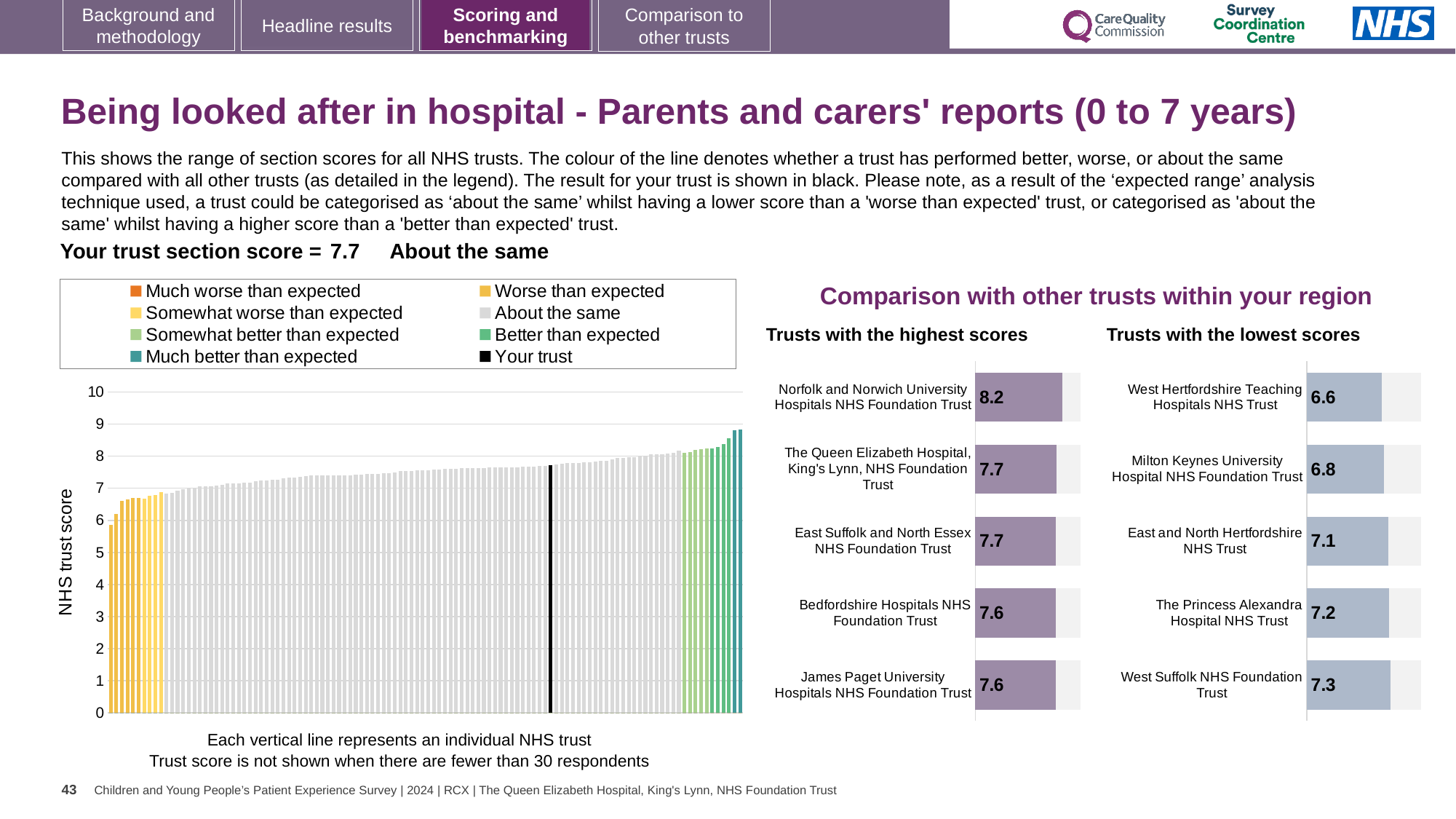
In the 'Trusts with the highest scores' chart, what is the difference between the scores of Norfolk and Norwich University Hospitals NHS Foundation Trust and James Paget University Hospitals NHS Foundation Trust? 0.6 In the 'Trusts with the highest scores' chart, which trust has the highest score? Norfolk and Norwich University Hospitals NHS Foundation Trust In the main chart on the left, is the value of the tallest bar greater or less than 8? greater In the 'Trusts with the lowest scores' chart, which has the larger score: East and North Hertfordshire NHS Trust or West Suffolk NHS Foundation Trust? West Suffolk NHS Foundation Trust How many entries does the legend of the main chart on the left list? 8 In the 'Trusts with the highest scores' chart, what is the score for Norfolk and Norwich University Hospitals NHS Foundation Trust? 8.2 In the 'Trusts with the lowest scores' chart, which trust has the lowest score? West Hertfordshire Teaching Hospitals NHS Trust How many trusts are shown in the 'Trusts with the lowest scores' chart? 5 In the main chart on the left, what is the section score for your trust (the black line)? 7.7 What type of chart is the main chart on the left of the slide? bar chart In the 'Trusts with the lowest scores' chart, what is the score for Milton Keynes University Hospital NHS Foundation Trust? 6.8 In the main chart on the left, do the trust scores rise or fall from left to right? rise